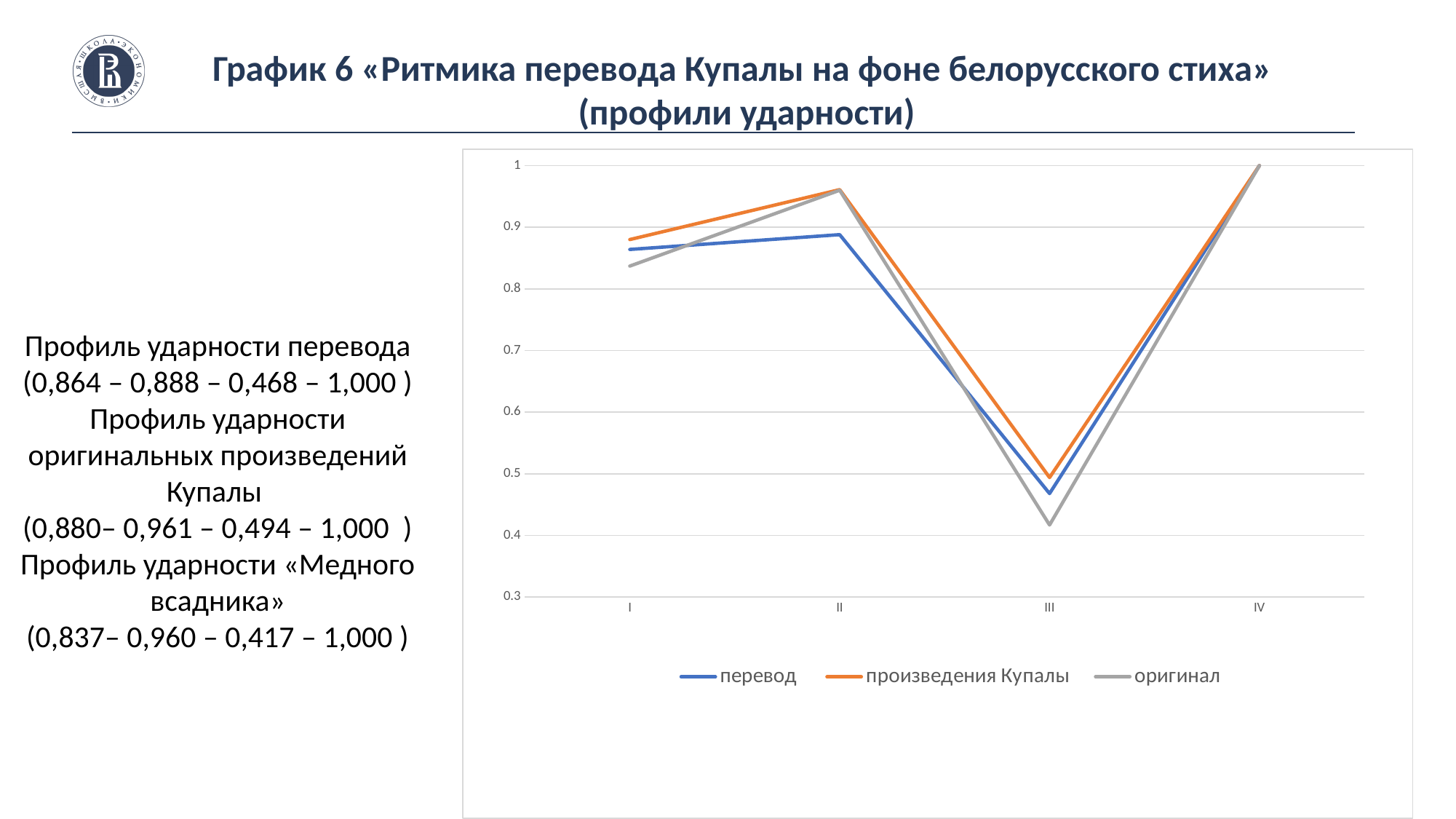
What kind of chart is shown on the slide? line chart At position III, which series has the higher value: произведения Купалы or оригинал? произведения Купалы What colour is the line for the оригинал series? grey At position II, which series has the higher value: перевод or произведения Купалы? произведения Купалы Is the value for произведения Купалы at position II greater or less than 0.9? greater At which position does the оригинал series reach its highest value? IV Is the value for оригинал at position III greater or less than 0.5? less What value do all three series reach at position IV? 1 How many series does the legend list? 3 Do the values of the перевод series rise or fall from position II to position III? fall How many positions are marked along the x axis? 4 At which position does the перевод series reach its lowest value? III